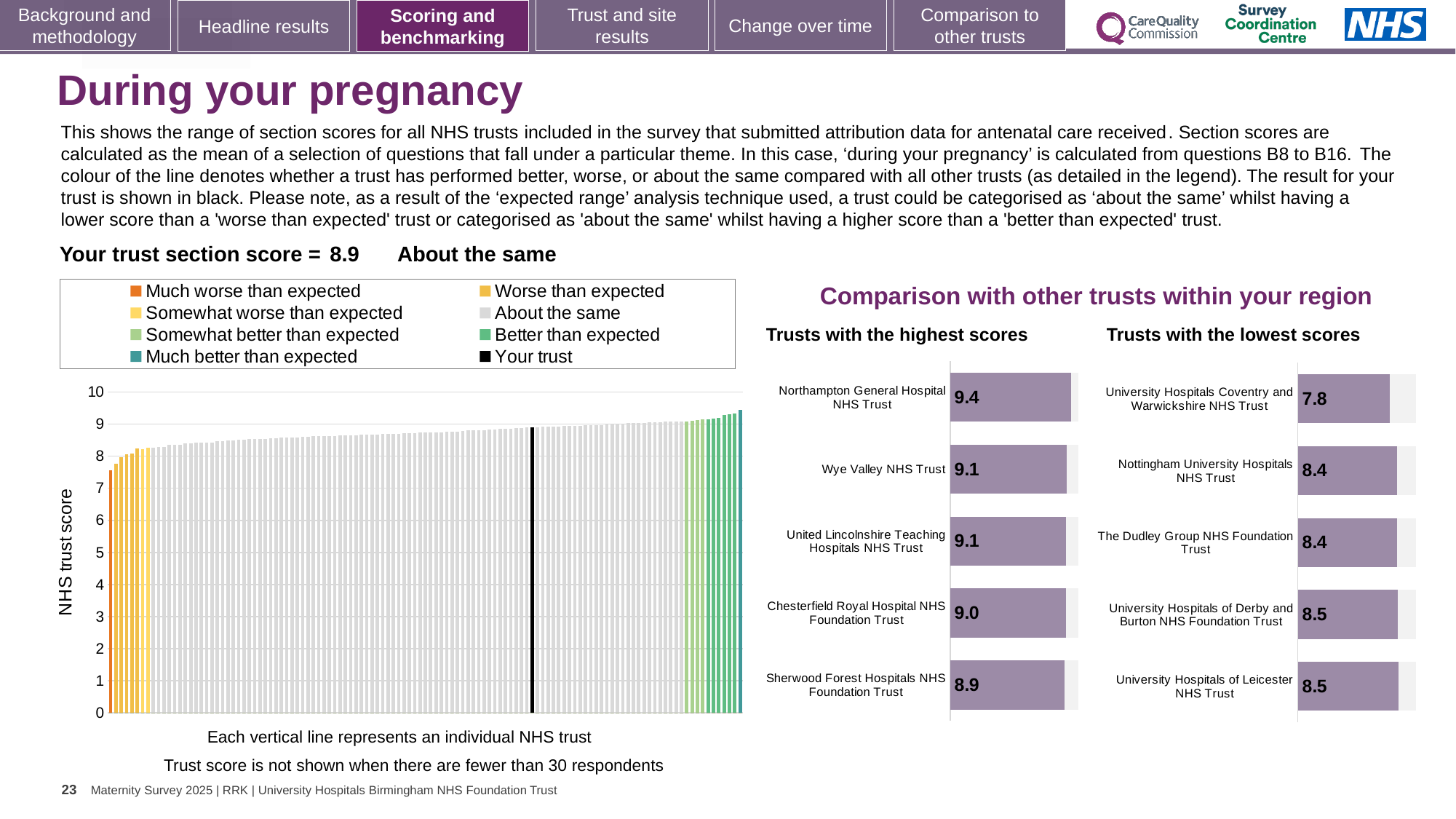
In the 'Trusts with the highest scores' chart, what is the score for Northampton General Hospital NHS Trust? 9.4 In the 'Trusts with the highest scores' chart, what is the difference between the scores of Northampton General Hospital NHS Trust and Sherwood Forest Hospitals NHS Foundation Trust? 0.5 In the 'Trusts with the highest scores' chart, which trust has the highest score? Northampton General Hospital NHS Trust In the 'Trusts with the lowest scores' chart, which trust has the lowest score? University Hospitals Coventry and Warwickshire NHS Trust In the 'Trusts with the lowest scores' chart, what is the difference between the scores of University Hospitals of Leicester NHS Trust and University Hospitals Coventry and Warwickshire NHS Trust? 0.7 What kind of chart is the main chart on the left showing NHS trust scores? Bar chart In the 'Trusts with the lowest scores' chart, how many trusts are shown? 5 In the 'Trusts with the highest scores' chart, which has the higher score: Wye Valley NHS Trust or Chesterfield Royal Hospital NHS Foundation Trust? Wye Valley NHS Trust In the 'Trusts with the highest scores' chart, what is the score for Chesterfield Royal Hospital NHS Foundation Trust? 9.0 In the main 'NHS trust score' chart, do the values rise or fall from left to right? Rise In the 'Trusts with the lowest scores' chart, what is the score for University Hospitals Coventry and Warwickshire NHS Trust? 7.8 How many entries does the legend of the main 'NHS trust score' chart list? 8